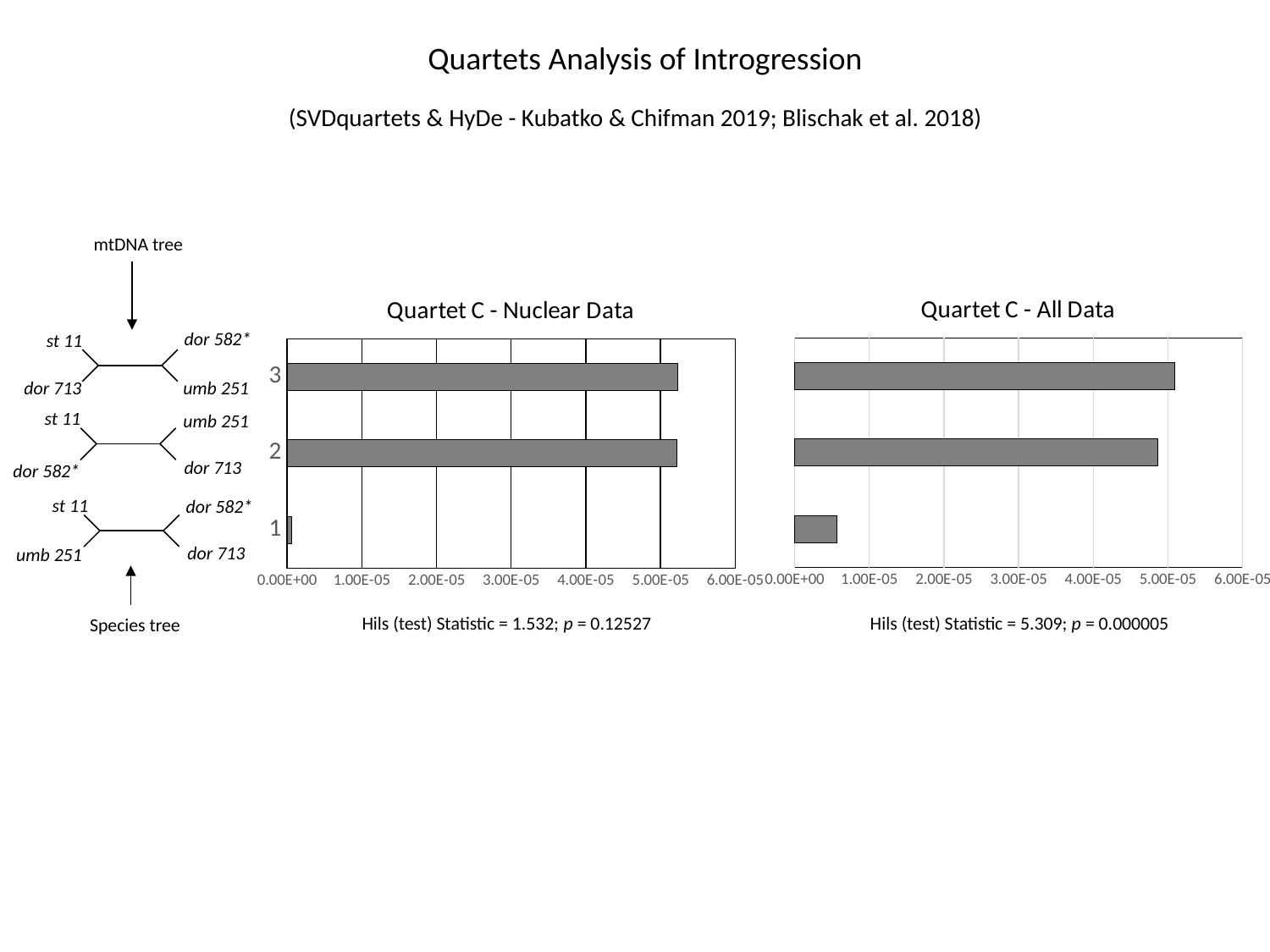
In the 'Quartet C - Nuclear Data' chart, what is the highest value shown on the x axis? 6.00E-05 In the 'Quartet C - Nuclear Data' chart, what kind of chart is shown? bar chart In the 'Quartet C - Nuclear Data' chart, which category has the lowest value? 1 In the 'Quartet C - Nuclear Data' chart, is the value for category 3 greater or less than 5.00E-05? greater In the 'Quartet C - Nuclear Data' chart, which is larger, the value for category 2 or category 1? category 2 In the 'Quartet C - All Data' chart, how many bars are plotted? 3 What is the title of the chart on the right side of the slide? Quartet C - All Data In the 'Quartet C - Nuclear Data' chart, is the value for category 1 greater or less than 1.00E-05? less